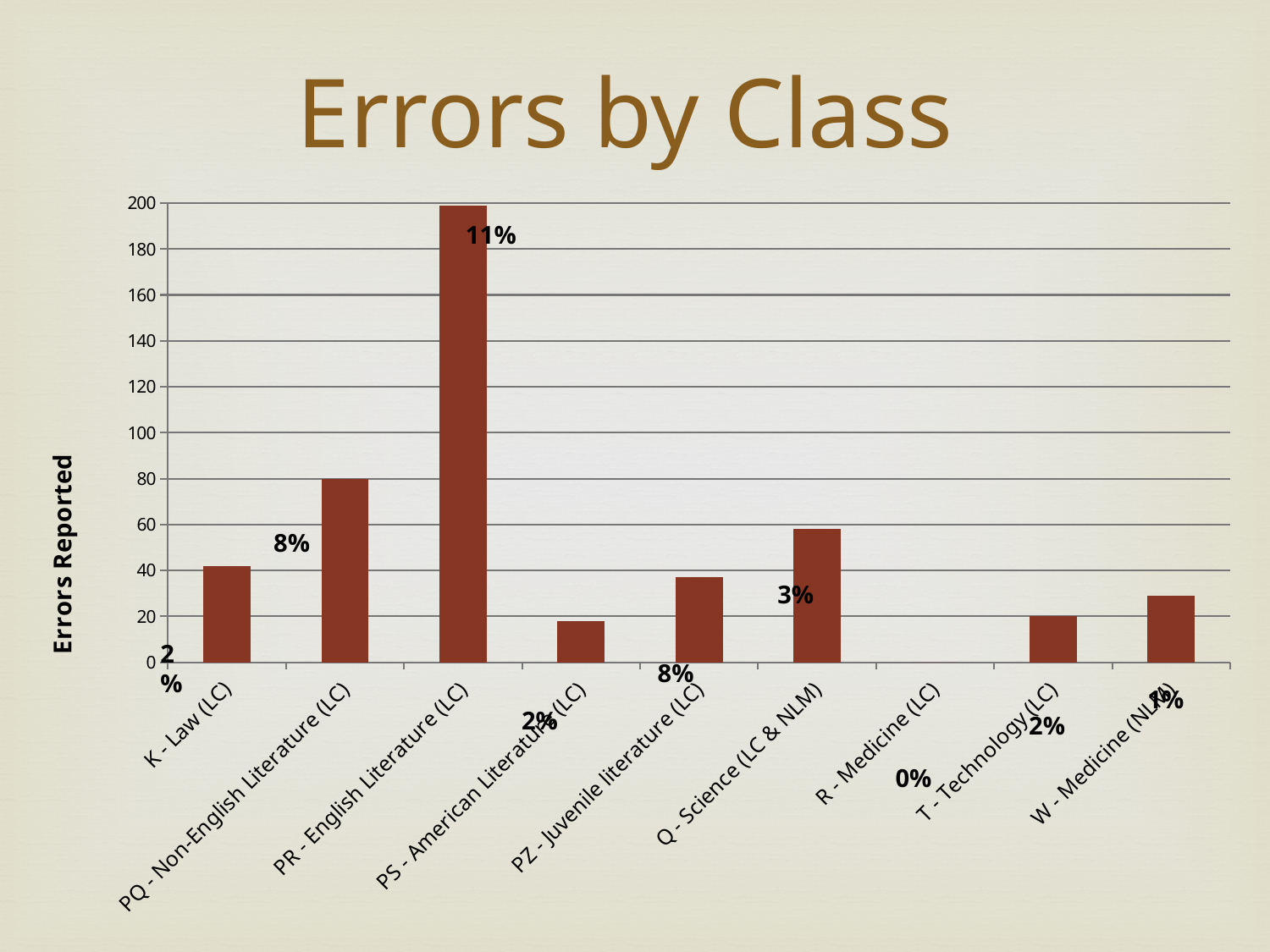
Which class has the highest number of errors reported? PR - English Literature (LC) Is the value for Q - Science (LC & NLM) greater or less than 40? greater What kind of chart is shown on the slide? bar chart Which has more errors reported, PQ - Non-English Literature (LC) or Q - Science (LC & NLM)? PQ - Non-English Literature (LC) Which class has the lowest number of errors reported? R - Medicine (LC) What is the percentage label shown on the PR - English Literature (LC) bar? 11% Is the value for K - Law (LC) greater or less than 60? less What is the percentage label shown for R - Medicine (LC)? 0% Is the value for PR - English Literature (LC) greater or less than 180? greater How many classes (categories) are plotted on the x axis? 9 What is the title of the chart? Errors by Class What is the label of the vertical axis? Errors Reported